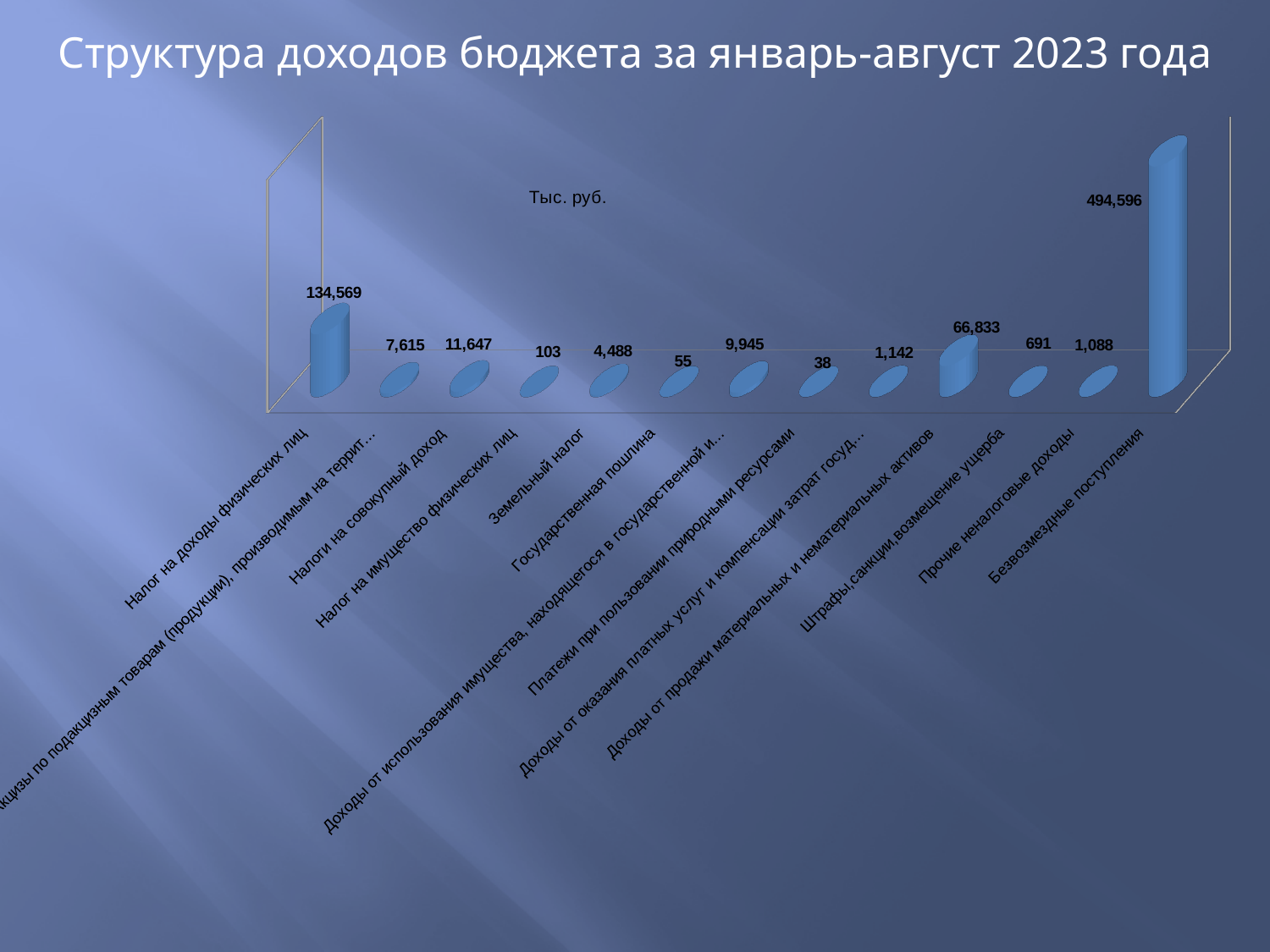
What is the value for Штрафы, санкции, возмещение ущерба? 691 What kind of chart is shown on the slide? Bar chart What is the title of the slide? Структура доходов бюджета за январь-август 2023 года What is the value for Безвозмездные поступления? 494,596 What is the difference between the values for Безвозмездные поступления and Налог на доходы физических лиц? 360,027 Which category has the highest value? Безвозмездные поступления How many categories are shown in the chart? 13 Which category has the lowest value? Платежи при пользовании природными ресурсами What is the value for Земельный налог? 4,488 What unit is indicated on the chart? Тыс. руб. Which is larger: the value for Налоги на совокупный доход or the value for Государственная пошлина? Налоги на совокупный доход What is the value for Налог на доходы физических лиц? 134,569